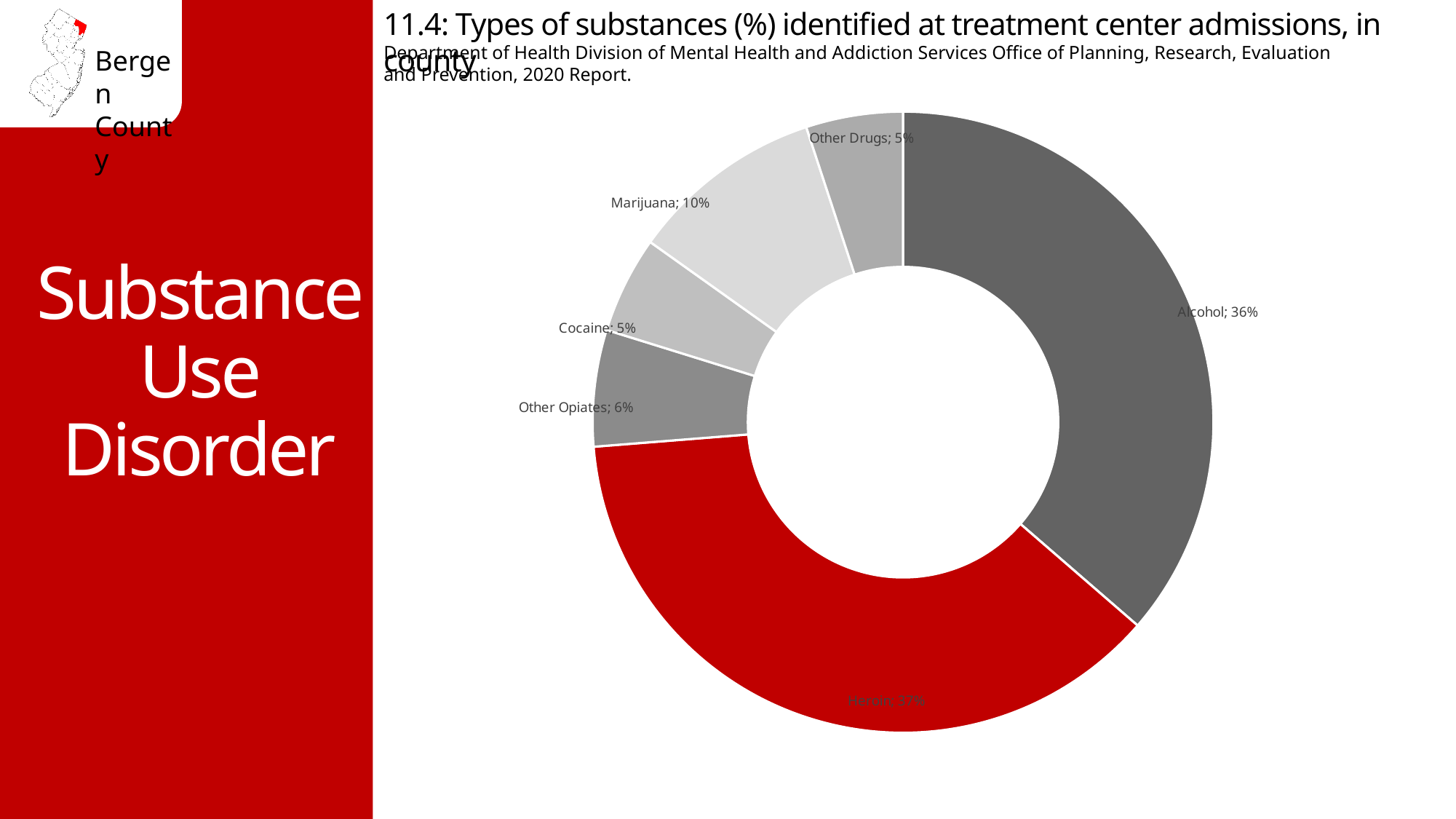
What percentage is shown for Cocaine? 5% What percentage is shown for Other Drugs? 5% Which is larger, the share for Marijuana or the share for Other Opiates? Marijuana What is the difference in percentage points between Alcohol and Marijuana? 26 What percentage is shown for Marijuana? 10% What percentage is shown for Heroin? 37% Which substance has the largest share of admissions? Heroin What type of chart is shown on the slide? Doughnut (pie) chart How many substance categories are shown in the chart? 6 What percentage of treatment center admissions is identified as Alcohol? 36% What percentage is shown for Other Opiates? 6% Which slice of the chart is coloured red? Heroin